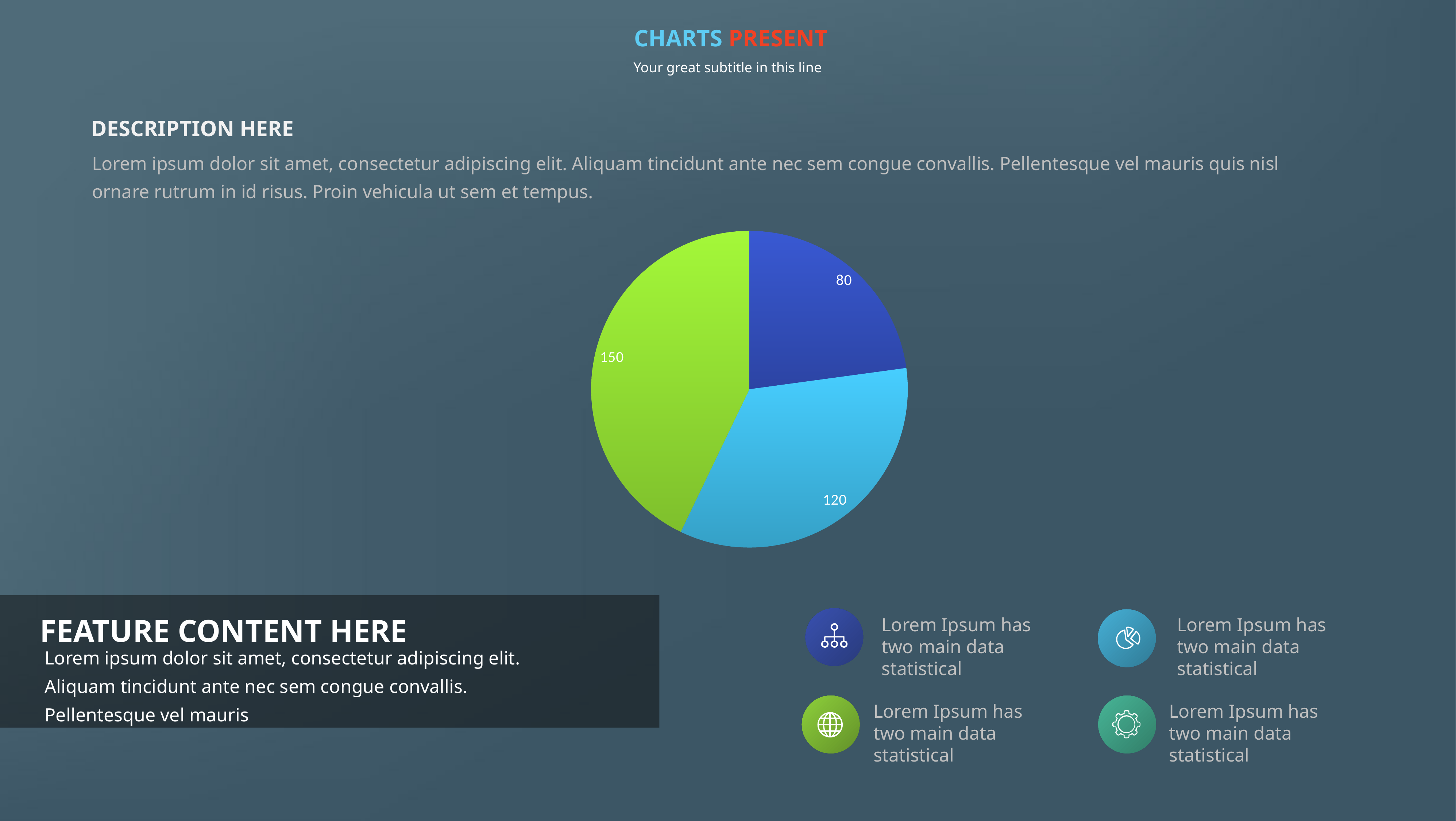
What is the title shown at the top of the slide above the chart? CHARTS PRESENT What is the value of the light blue slice of the pie chart? 120 How many slices does the pie chart have? 3 Which slice of the pie chart has the largest value? the green slice (150) What is the difference between the green slice and the dark blue slice of the pie chart? 70 What is the total of all the slice values in the pie chart? 350 What is the value of the dark blue slice of the pie chart? 80 What type of chart is shown on the slide? pie chart What share of the pie chart does the green slice represent? 42.9% Which is larger in the pie chart, the light blue slice or the dark blue slice? the light blue slice Which slice of the pie chart has the smallest value? the dark blue slice (80) What is the value of the green slice of the pie chart? 150